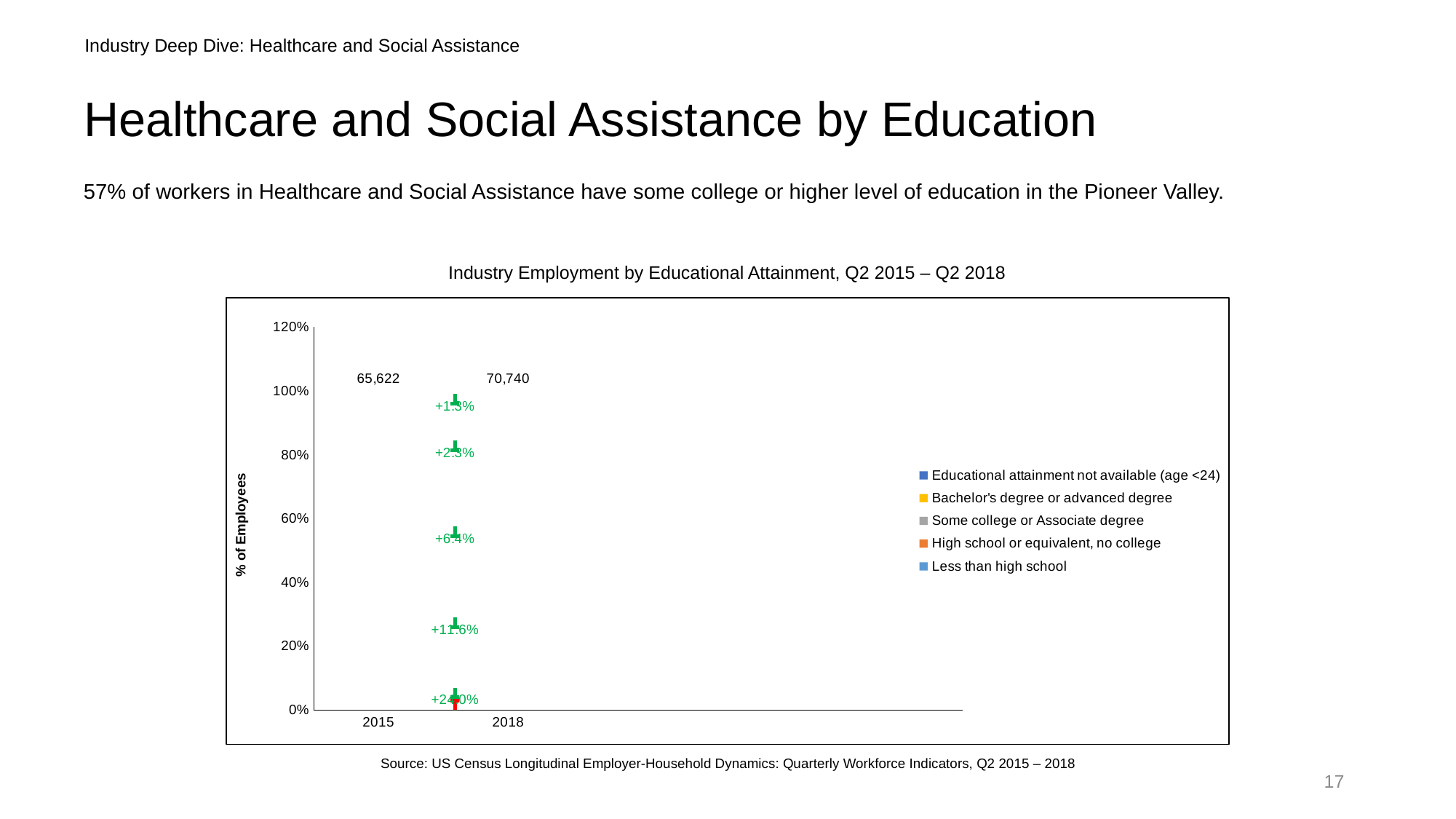
How many series does the legend of the chart list? 5 Which year has the larger total employment figure printed above its bar, 2015 or 2018? 2018 What is the difference between the total employment figures printed for 2018 and 2015? 5,118 What total employment figure is printed above the 2015 bar? 65,622 How many categories are shown on the x axis of the chart? 2 What is the highest tick value shown on the y axis? 120% What total employment figure is printed above the 2018 bar? 70,740 Does the total employment figure rise or fall from 2015 to 2018? rise What is the title of the chart? Industry Employment by Educational Attainment, Q2 2015 – Q2 2018 Which of the green change labels between the bars shows the largest percentage increase? +24.0% What is the label on the y axis of the chart? % of Employees